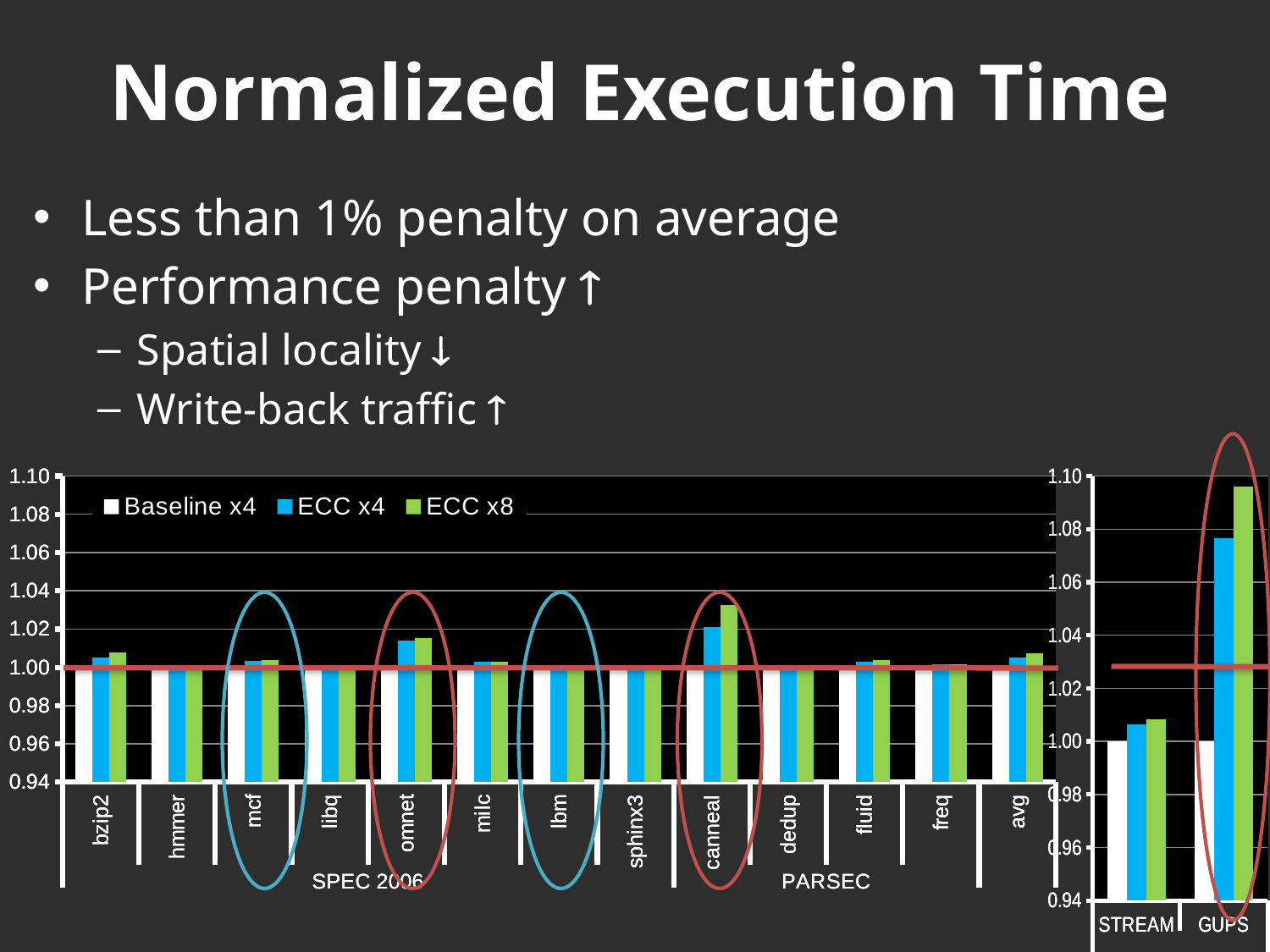
What kind of chart is the left chart showing SPEC 2006 and PARSEC benchmarks? bar chart In the right chart, which category has the larger ECC x4 value, STREAM or GUPS? GUPS In the right chart, is the ECC x8 value for GUPS greater or less than 1.08? greater What are the series names in the legend of the left chart? Baseline x4, ECC x4, ECC x8 In the left chart, which has the larger ECC x8 value, omnet or canneal? canneal In the left chart, is the ECC x4 value for omnet greater or less than 1.00? greater How many series does the legend of the left chart list? 3 In the left chart, is the ECC x8 value for canneal greater or less than 1.02? greater In the left chart, what is the Baseline x4 value for bzip2? 1.00 In the left chart, which benchmark has the highest ECC x8 value? canneal How many categories are shown on the x axis of the right chart (STREAM/GUPS)? 2 How many benchmark categories are shown on the x axis of the left chart? 13